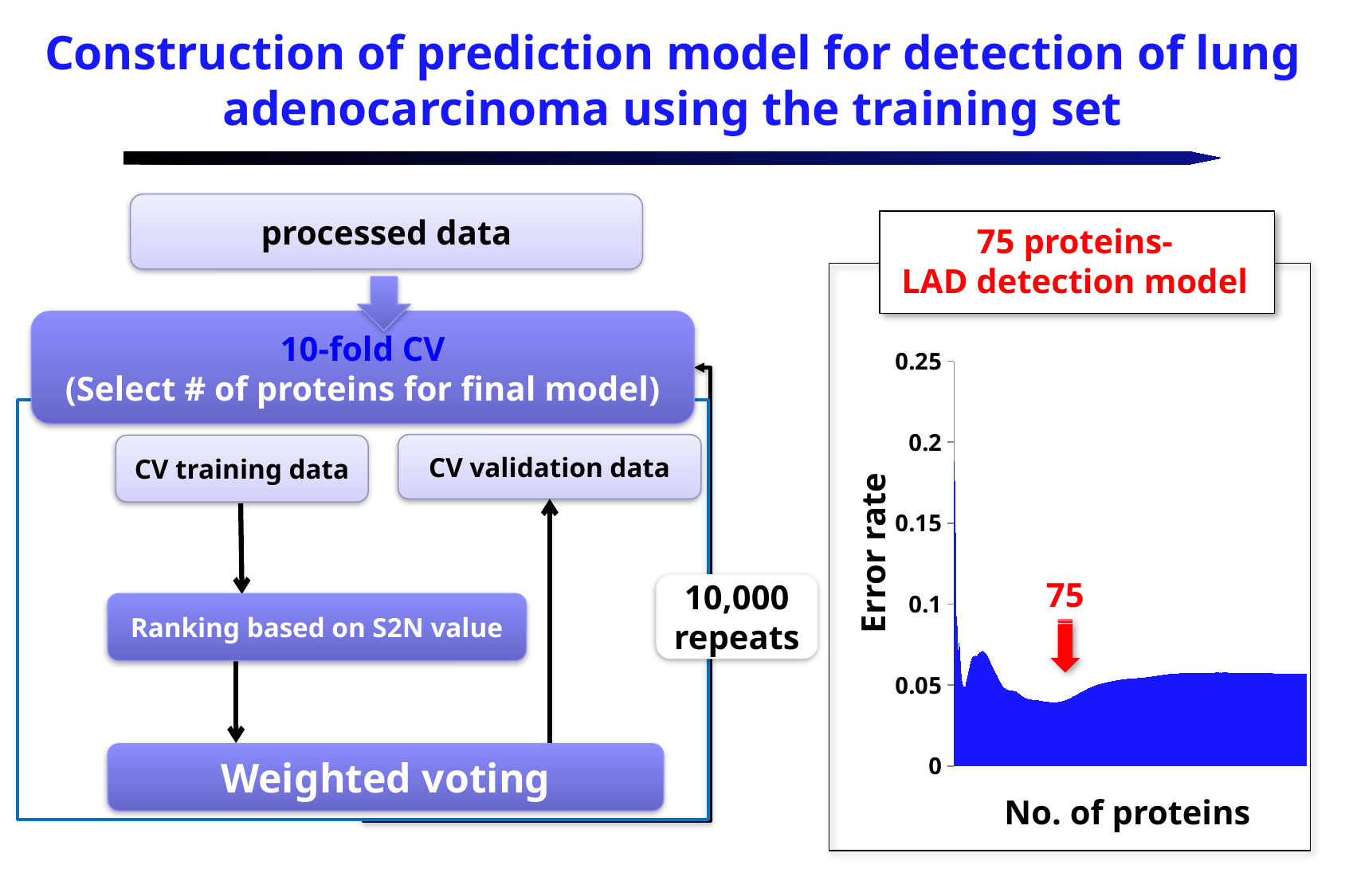
Is the error rate at 75 proteins greater or less than 0.1? less Is the error rate at the far left of the chart greater or less than the error rate at 75 proteins? greater Overall, does the error rate rise or fall from the left end of the chart to the right end? fall What number of proteins does the red arrow on the chart point to? 75 What kind of chart is shown in the '75 proteins- LAD detection model' panel? area chart What is the label of the y axis of the chart? Error rate How many data series are plotted in the chart? 1 What is the label of the x axis of the chart? No. of proteins Is the error rate at the far right end of the chart greater or less than 0.1? less Is the peak error rate at the far left of the chart greater or less than 0.15? greater What is the highest value shown on the y axis of the chart? 0.25